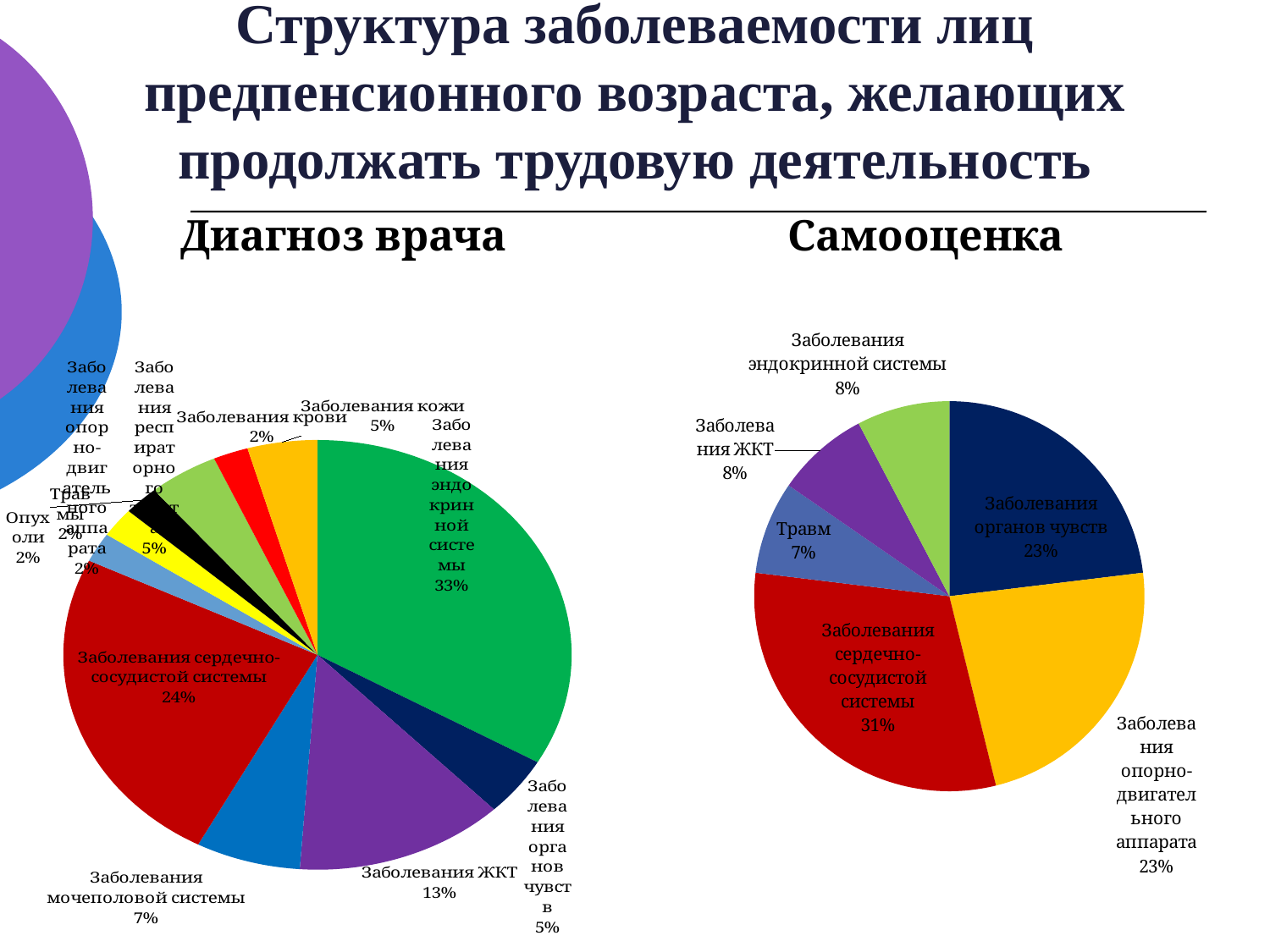
In the "Самооценка" chart, which category has the smallest share? Травм In the "Диагноз врача" chart, what share is shown for Заболевания ЖКТ? 13% In the "Самооценка" chart, what share is shown for Травм? 7% How many slices does the "Самооценка" pie chart have? 6 In the "Самооценка" chart, what share is shown for Заболевания сердечно-сосудистой системы? 31% What kind of chart is used under the heading "Диагноз врача"? pie chart Which is larger: the share of Заболевания ЖКТ in the "Диагноз врача" chart or in the "Самооценка" chart? Диагноз врача In the "Диагноз врача" chart, what share is shown for Заболевания сердечно-сосудистой системы? 24% In the "Диагноз врача" chart, which category has the largest share? Заболевания эндокринной системы In the "Самооценка" chart, which category has the largest share? Заболевания сердечно-сосудистой системы In the "Диагноз врача" chart, what is the difference between the shares of Заболевания эндокринной системы and Заболевания сердечно-сосудистой системы? 9% In the "Диагноз врача" chart, what share is shown for Заболевания эндокринной системы? 33%